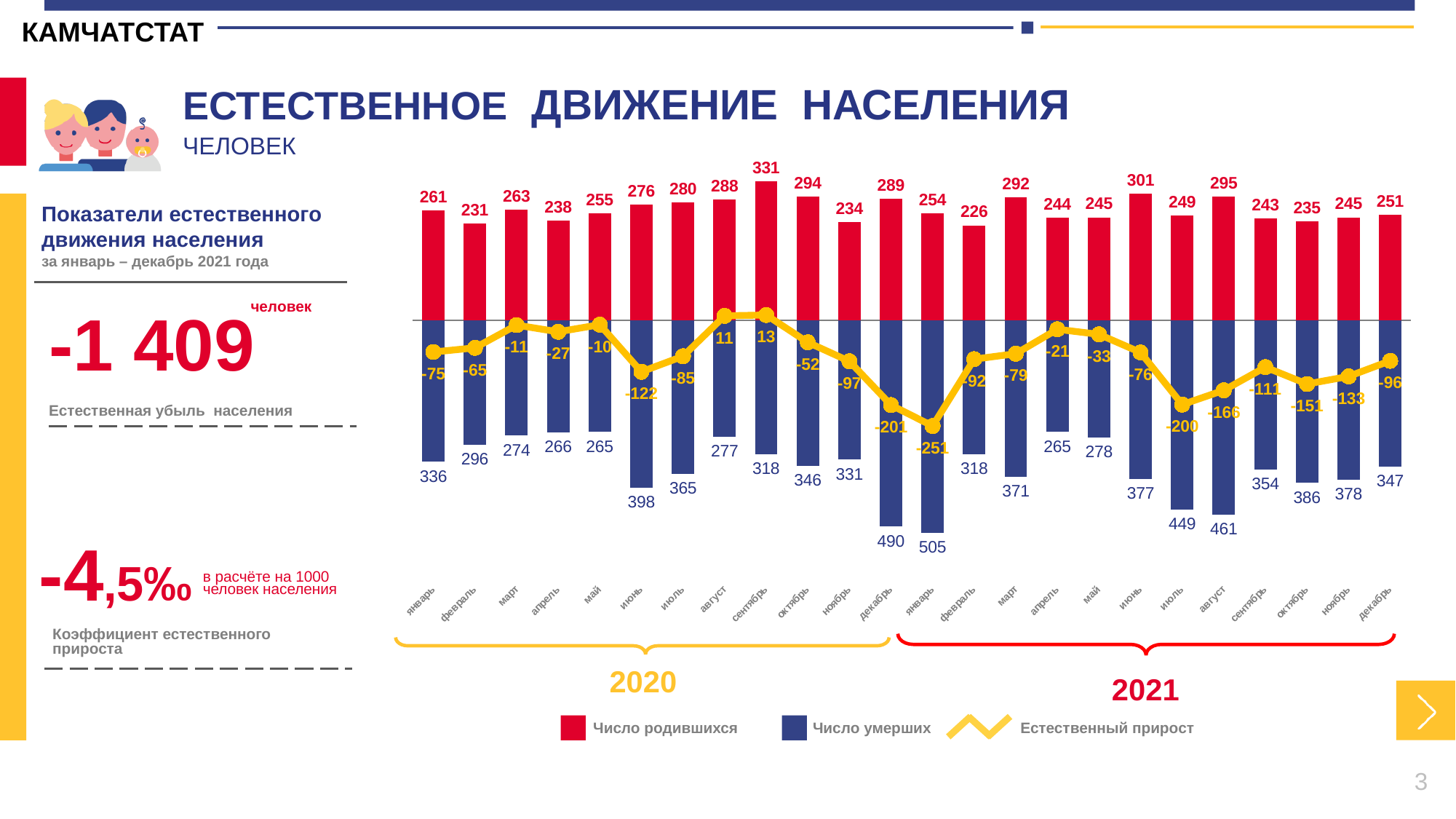
How many series does the legend list? 3 How many months (categories) are plotted on the x axis? 24 Which month has the lowest number of deaths across the whole chart? May 2020 (май 2020) and April 2021 (апрель 2021), both 265 What is the number of deaths (Число умерших) in January 2021? 505 What is the difference between deaths and births in January 2021? 251 Which is larger: the number of births in June 2021 or in June 2020? June 2021 (301) What is the natural increase (Естественный прирост) value for December 2020? -201 Which month has the highest number of births across the whole chart? September 2020 (сентябрь 2020) In which months is the natural increase (Естественный прирост) positive? August 2020 (11) and September 2020 (13) What is the number of births (Число родившихся) in September 2020? 331 What colour represents the number of deaths (Число умерших) in the chart? Dark blue What kind of chart is shown on the slide? Combined bar and line chart